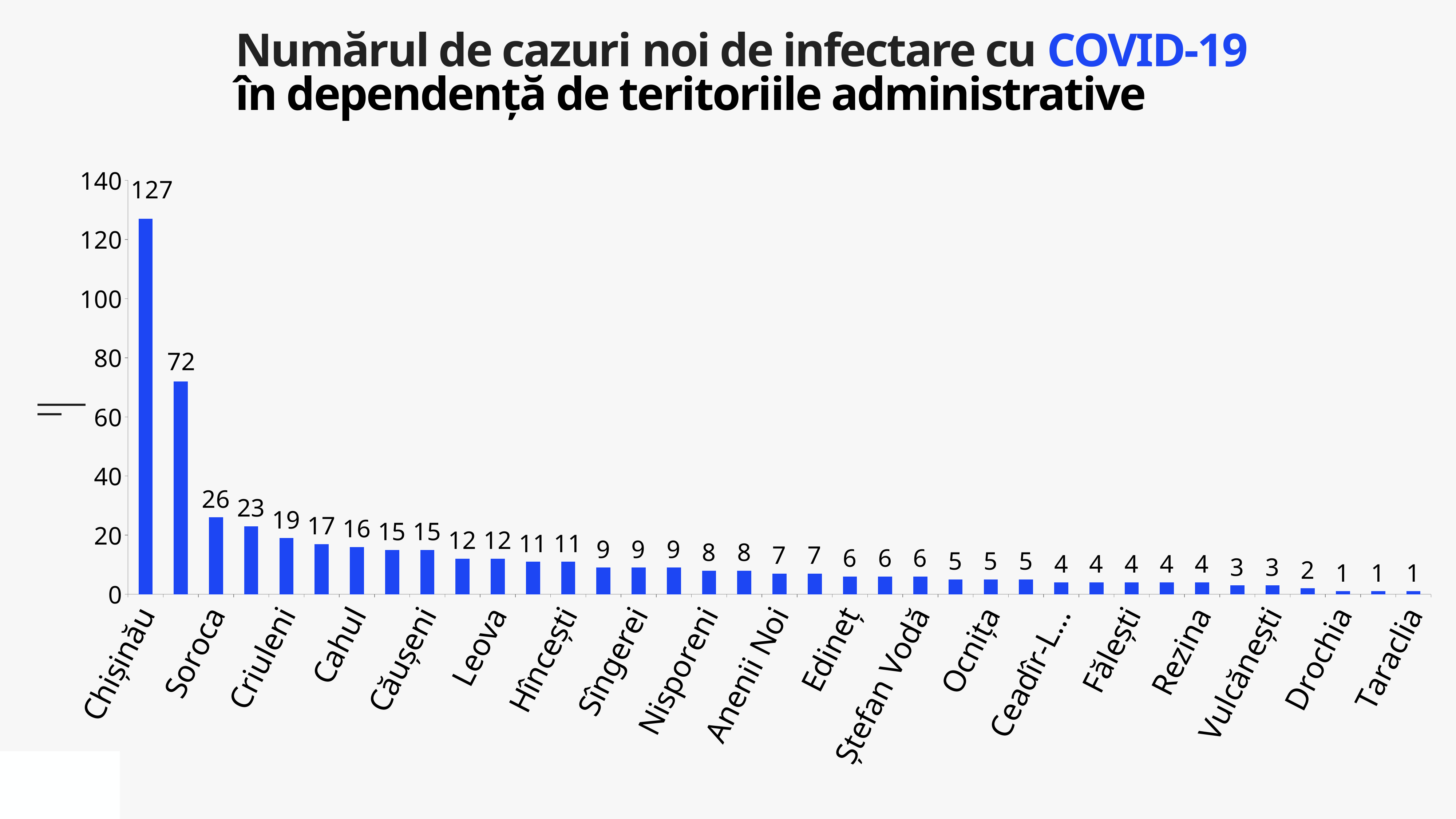
Which territory has the highest number of new cases? Chișinău What is the value for Chișinău? 127 What type of chart is shown on the slide? bar chart How many bars are plotted in the chart? 37 Which is larger, the value for Chișinău or the value for Taraclia? Chișinău What colour are the bars in the chart? blue What is the difference between the tallest bar (127) and the second-tallest bar (72)? 55 Do the values rise or fall from left to right along the x axis? fall What is the highest tick value shown on the vertical axis? 140 What is the value of the second-tallest bar? 72 What is the value for Taraclia? 1 Is the value for Chișinău greater or less than 100? greater